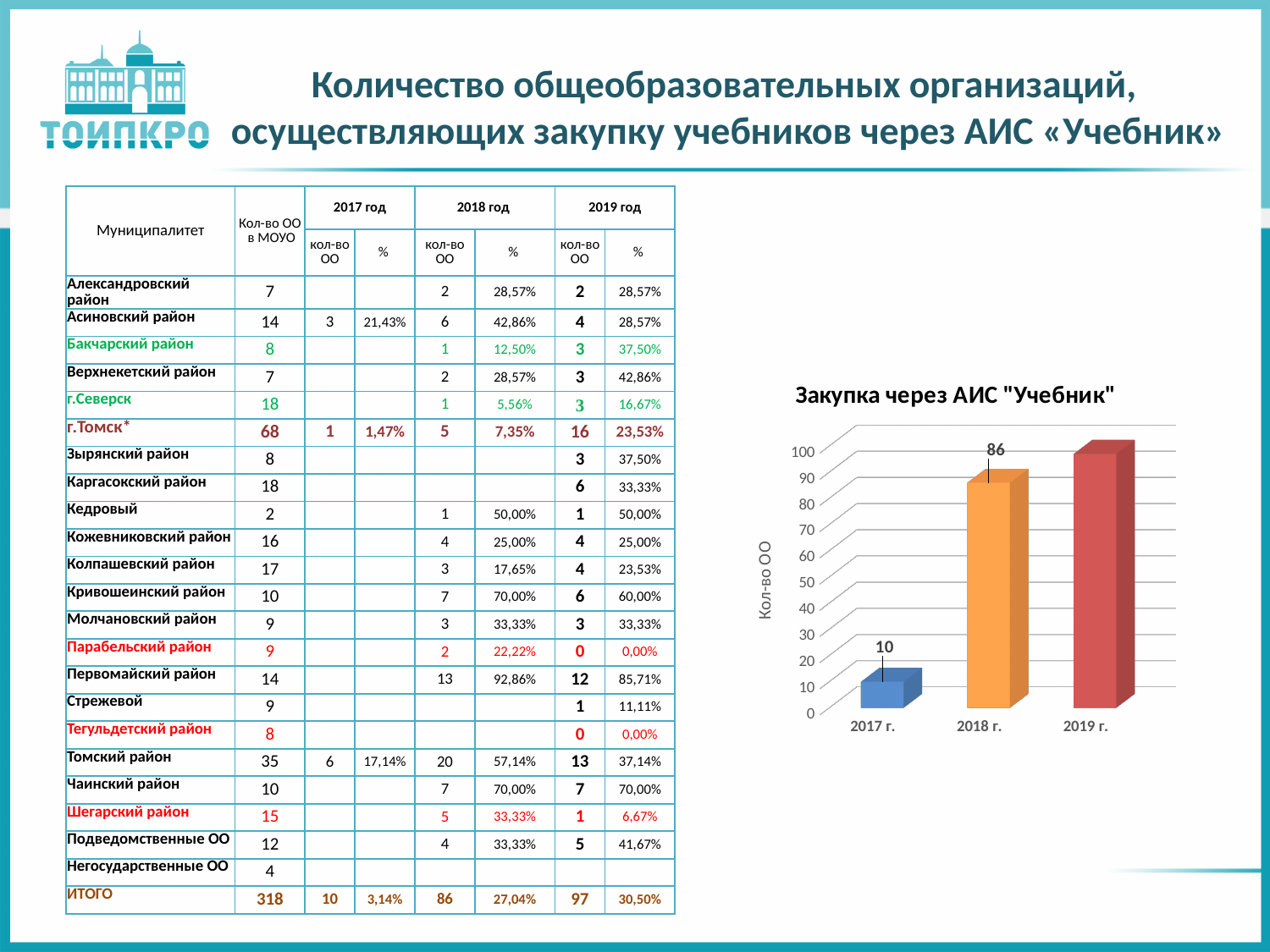
Which year has the lowest bar in the chart "Закупка через АИС "Учебник""? 2017 г. What is the value for 2018 г. in the chart "Закупка через АИС "Учебник""? 86 What kind of chart is "Закупка через АИС "Учебник""? bar chart In the chart "Закупка через АИС "Учебник"", what is the difference between the values for 2018 г. and 2017 г.? 76 Do the values in the chart "Закупка через АИС "Учебник"" rise or fall from 2017 г. to 2019 г.? rise How many years are shown on the x axis of the chart "Закупка через АИС "Учебник""? 3 What is the value for 2017 г. in the chart "Закупка через АИС "Учебник""? 10 What is the title of the chart on the right side of the slide? Закупка через АИС "Учебник" In the chart "Закупка через АИС "Учебник"", is the value for 2019 г. greater or less than 90? greater In the chart "Закупка через АИС "Учебник"", which is larger: the value for 2018 г. or for 2017 г.? 2018 г. What is the label of the vertical axis in the chart "Закупка через АИС "Учебник""? Кол-во ОО Which year has the highest bar in the chart "Закупка через АИС "Учебник""? 2019 г.